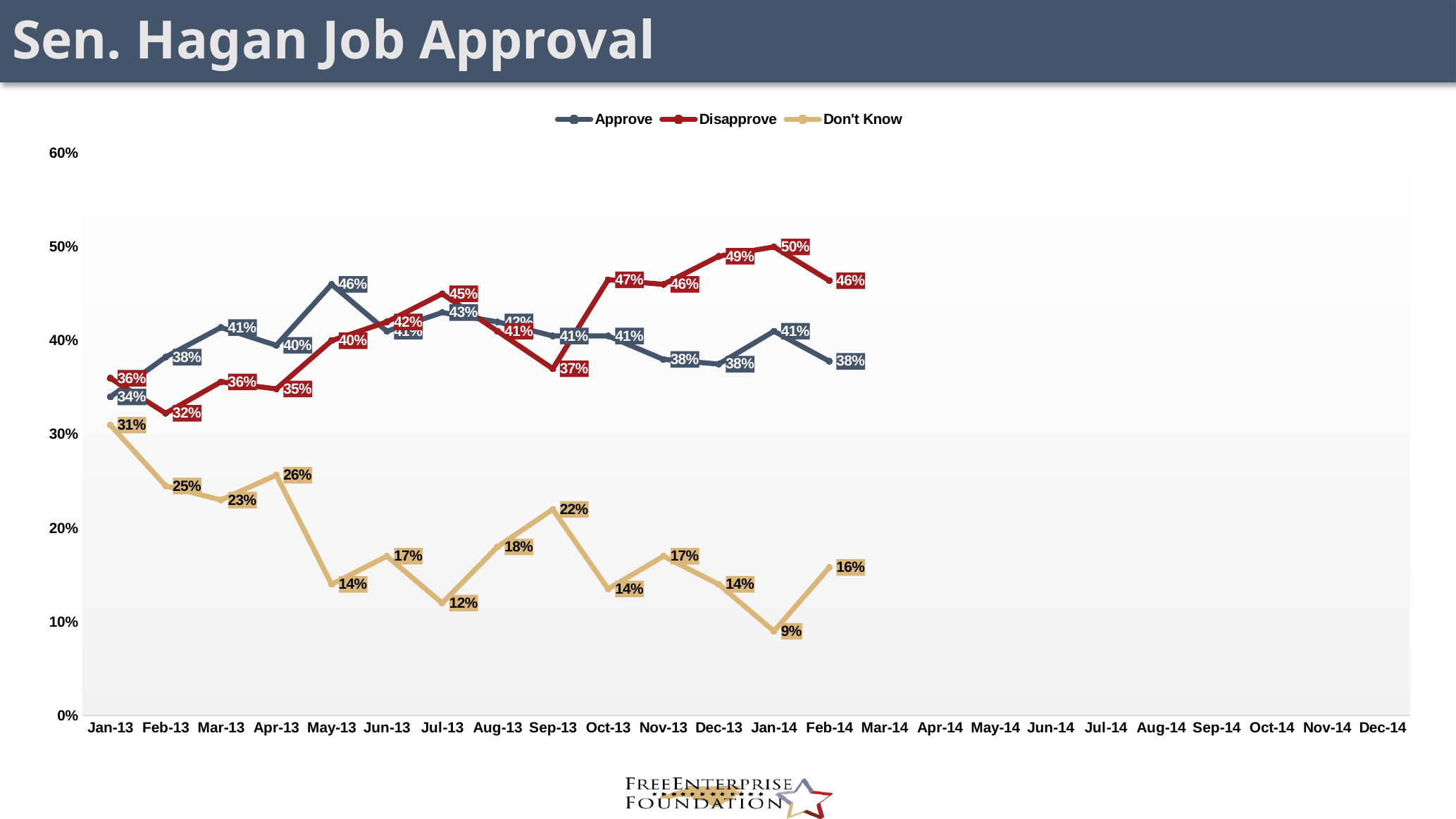
What colour is the Disapprove line? red What is the Disapprove value for Jan-14? 50% What is the Approve value for May-13? 46% Does the Don't Know series generally rise or fall from Jan-13 to Jan-14? fall Which is larger in Jan-13, Approve or Disapprove? Disapprove What kind of chart is shown on the slide? line chart What is the difference between the Disapprove and Approve values in Feb-14? 8% In which month does the Don't Know series reach its lowest value? Jan-14 In which month does the Disapprove series reach its highest value? Jan-14 What is the Don't Know value for Jan-13? 31% Is the Don't Know value for Jul-13 greater or less than 20%? less How many series does the legend list? 3